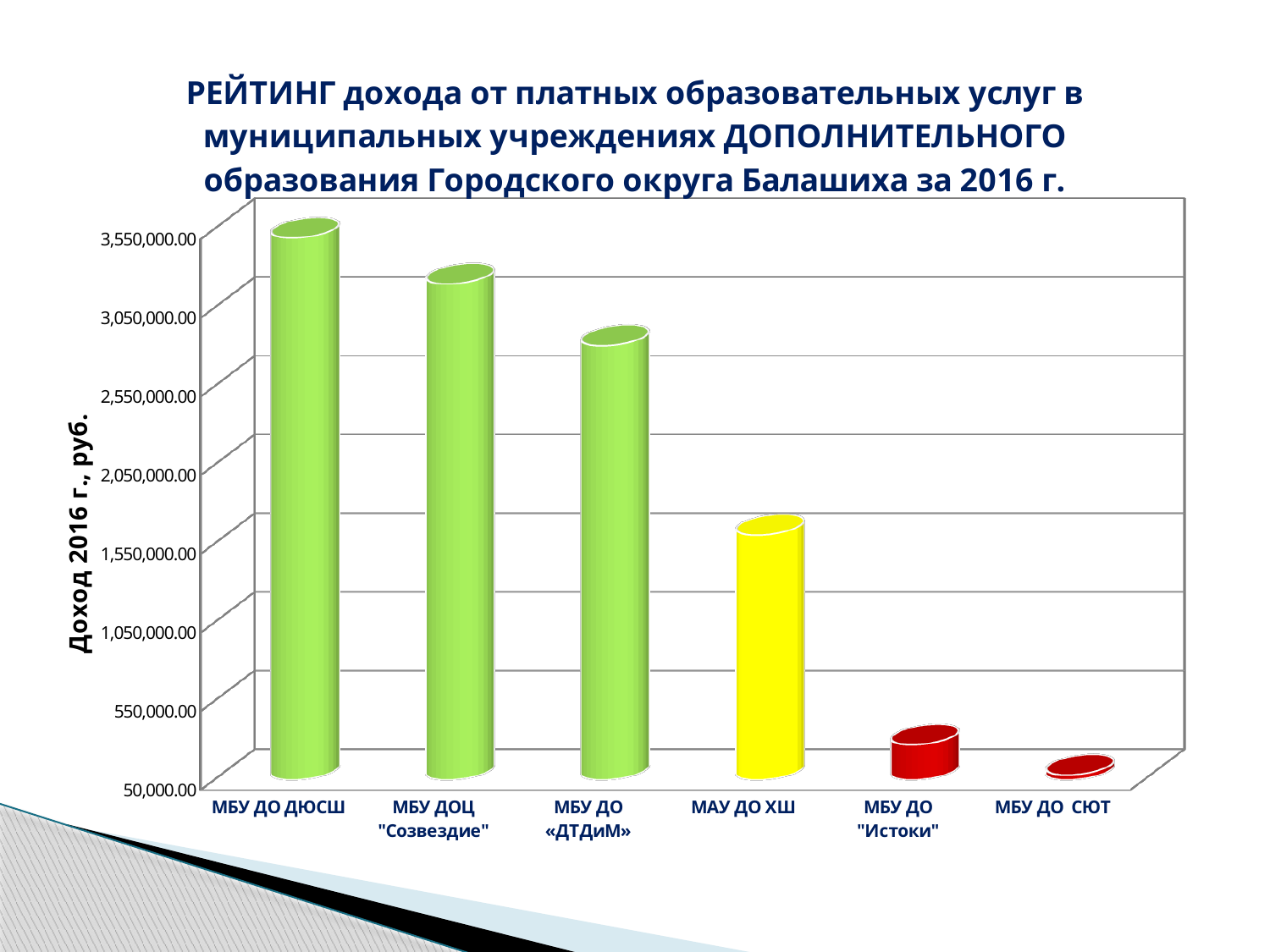
How many institutions (categories) are shown on the x axis? 6 What is the label of the vertical axis? Доход 2016 г., руб. Which institution has the lowest income from paid educational services? МБУ ДО СЮТ What kind of chart is shown on the slide? bar chart Is the value for МБУ ДО "Истоки" greater or less than 550,000.00? less Which has the larger value: МБУ ДОЦ "Созвездие" or МБУ ДО «ДТДиМ»? МБУ ДОЦ "Созвездие" Which has the larger value: МАУ ДО ХШ or МБУ ДО "Истоки"? МАУ ДО ХШ Do the values rise or fall moving from left to right along the x axis? fall Which institution has the highest income from paid educational services? МБУ ДО ДЮСШ Is the value for МБУ ДО «ДТДиМ» greater or less than 3,050,000.00? less Is the value for МАУ ДО ХШ greater or less than 2,050,000.00? less